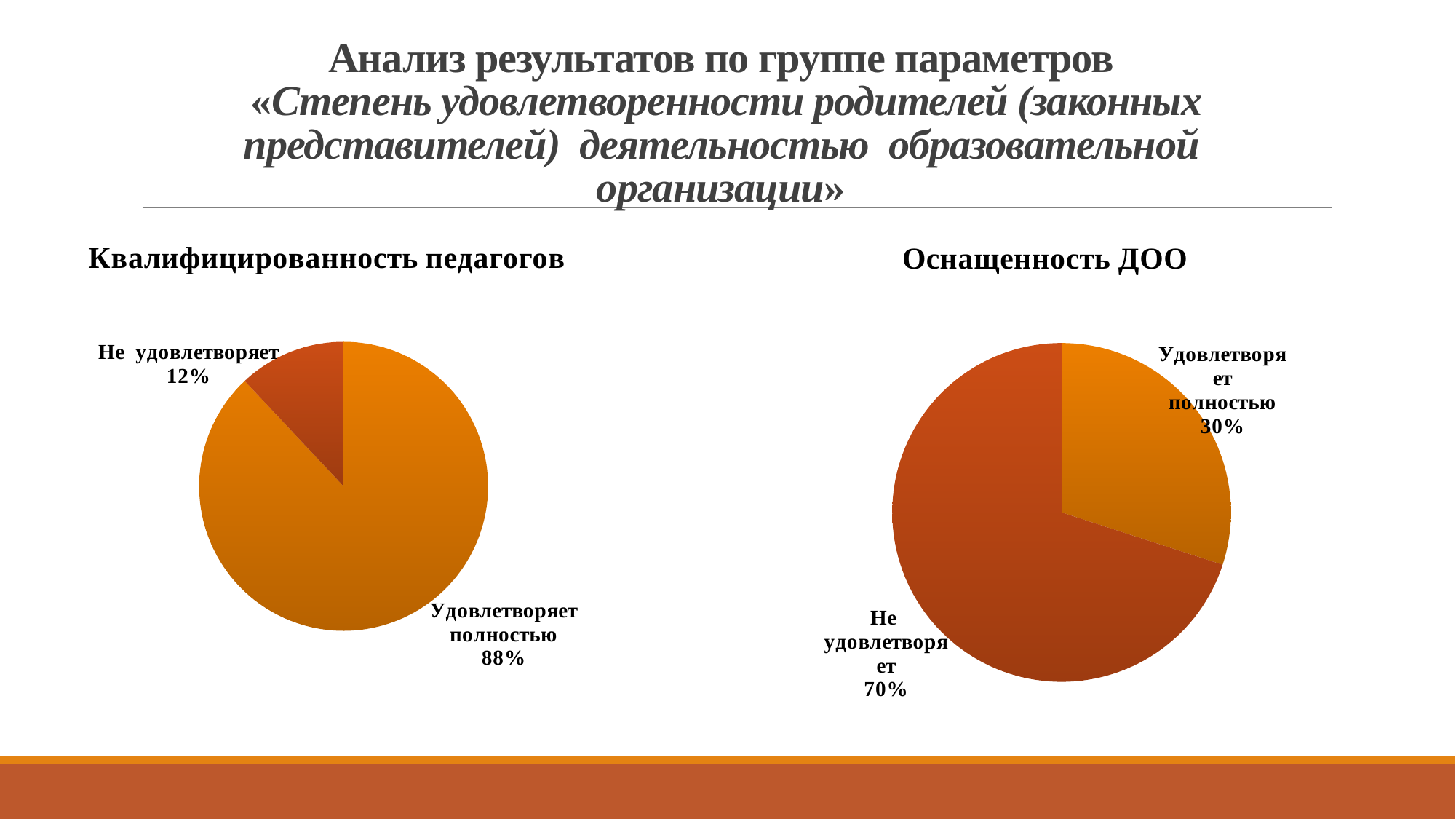
How many charts are shown on the slide? 2 In the 'Квалифицированность педагогов' chart, what share is labelled 'Не удовлетворяет'? 12% In the 'Оснащенность ДОО' chart, which slice is the smallest? Удовлетворяет полностью In the 'Квалифицированность педагогов' chart, what share is labelled 'Удовлетворяет полностью'? 88% In the 'Квалифицированность педагогов' chart, which slice is the largest? Удовлетворяет полностью What type of chart is the 'Квалифицированность педагогов' chart? Pie chart Which chart has the larger 'Удовлетворяет полностью' share, 'Квалифицированность педагогов' or 'Оснащенность ДОО'? Квалифицированность педагогов In the 'Оснащенность ДОО' chart, what is the difference between the 'Не удовлетворяет' and 'Удовлетворяет полностью' shares? 40% In the 'Оснащенность ДОО' chart, what share is labelled 'Удовлетворяет полностью'? 30% In the 'Оснащенность ДОО' chart, what share is labelled 'Не удовлетворяет'? 70% How many slices does the 'Оснащенность ДОО' chart have? 2 In the 'Квалифицированность педагогов' chart, what is the difference between the 'Удовлетворяет полностью' and 'Не удовлетворяет' shares? 76%